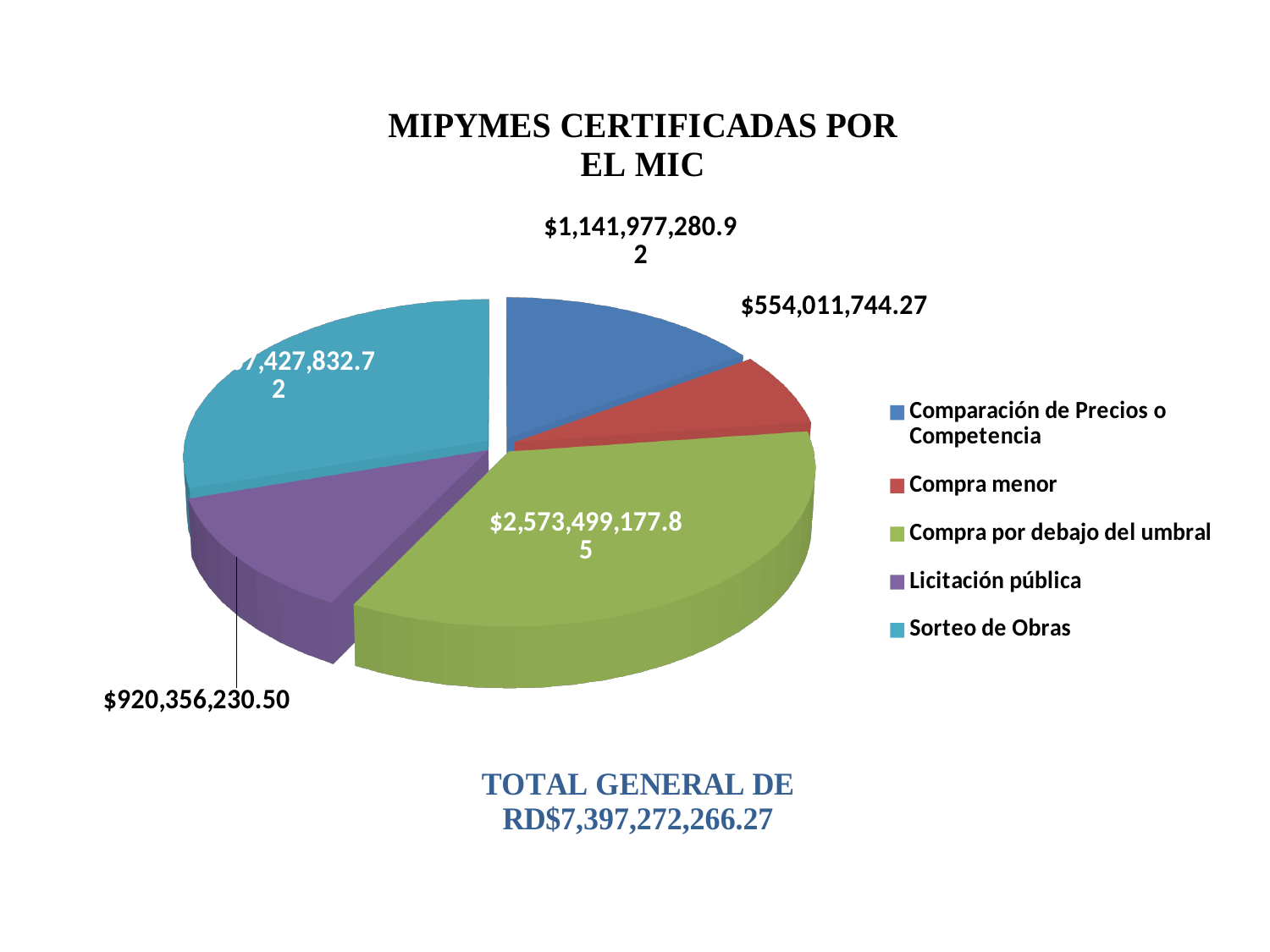
What type of chart is shown on the slide? Pie chart What is the value for Licitación pública? $920,356,230.50 Which category has the largest slice of the pie? Compra por debajo del umbral What is the value for Compra por debajo del umbral? $2,573,499,177.85 What is the value for Compra menor? $554,011,744.27 What is the title of the chart? MIPYMES CERTIFICADAS POR EL MIC Which category has the smallest slice of the pie? Compra menor What is the value for Comparación de Precios o Competencia? $1,141,977,280.92 What is the total general amount stated below the chart? RD$7,397,272,266.27 What is the difference between the values for Comparación de Precios o Competencia and Compra menor? $587,965,536.65 How many categories does the legend list? 5 Which is larger, Comparación de Precios o Competencia or Compra menor? Comparación de Precios o Competencia